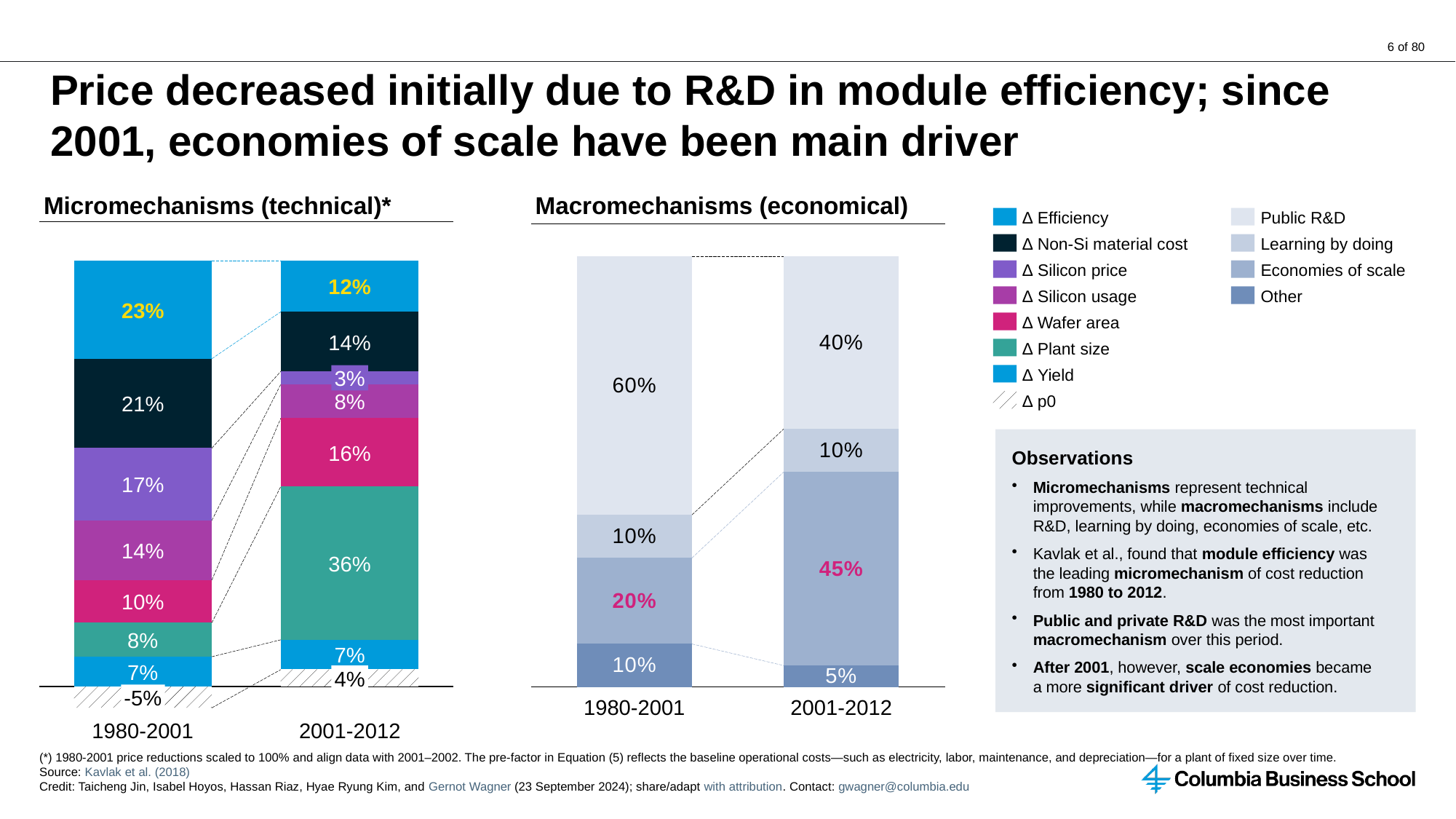
In the Macromechanisms (economical) chart, what is the value for Public R&D in 1980-2001? 60% In the Micromechanisms (technical) chart, what is the value for Δ Plant size in 2001-2012? 36% In the Micromechanisms (technical) chart, which mechanism has the largest segment in the 2001-2012 bar? Δ Plant size In the Macromechanisms (economical) chart, what is the value for Economies of scale in 2001-2012? 45% In the Macromechanisms (economical) chart, by how many percentage points did Economies of scale increase from 1980-2001 to 2001-2012? 25 percentage points In the Micromechanisms (technical) chart, by how many percentage points did Δ Efficiency decrease from 1980-2001 to 2001-2012? 11 percentage points How many time periods are shown on the x axis of the Macromechanisms (economical) chart? 2 In the Macromechanisms (economical) chart, which mechanism has the smallest segment in the 2001-2012 bar? Other In the Micromechanisms (technical) chart, what is the value for Δ p0 in 1980-2001? -5% In the Macromechanisms (economical) chart, does the Public R&D share rise or fall from 1980-2001 to 2001-2012? Fall What kind of chart is the Macromechanisms (economical) chart? Stacked bar chart In the Micromechanisms (technical) chart, is the Δ Wafer area value larger in 1980-2001 or in 2001-2012? 2001-2012